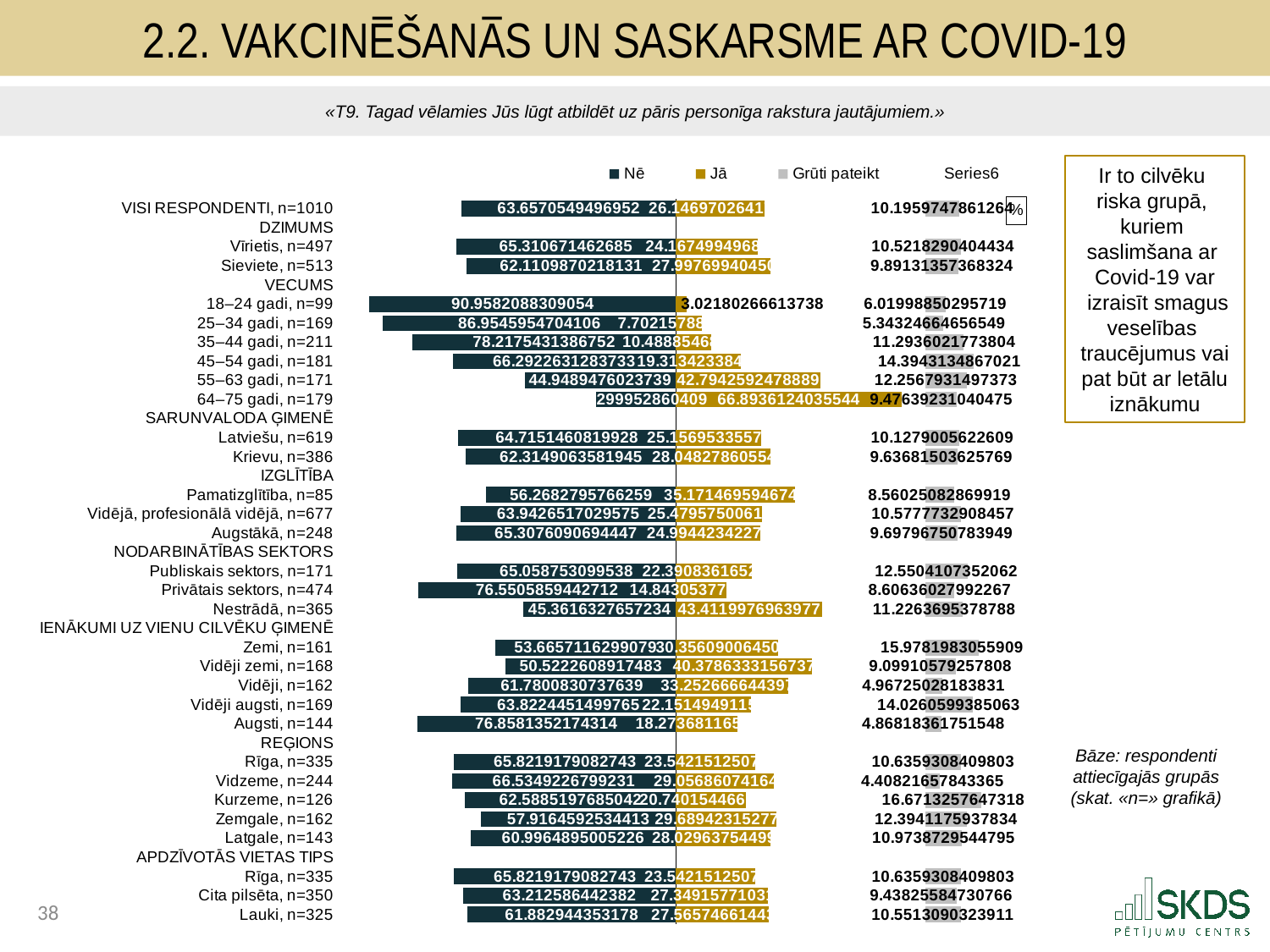
What is the "Nē" value for VISI RESPONDENTI, n=1010? 63.6570549496952 What is the "Grūti pateikt" value for Kurzeme, n=126? 16.6713257647318 What is the difference between the "Nē" values for 18–24 gadi, n=99 and 25–34 gadi, n=169? 4.0036133604948 Which region has the lowest "Grūti pateikt" value? Vidzeme, n=244 What is the "Jā" value for 55–63 gadi, n=171? 42.7942592478889 Which age group has the highest "Nē" value? 18–24 gadi, n=99 How many series does the chart legend list? 4 Which age group has the highest "Jā" value? 64–75 gadi, n=179 What is the "Nē" value for Privātais sektors, n=474? 76.5505859442712 What type of chart is shown on the slide? Bar chart Which has a larger "Nē" value: Publiskais sektors, n=171 or Privātais sektors, n=474? Privātais sektors, n=474 What is the "Grūti pateikt" value for Vīrietis, n=497? 10.5218290404434